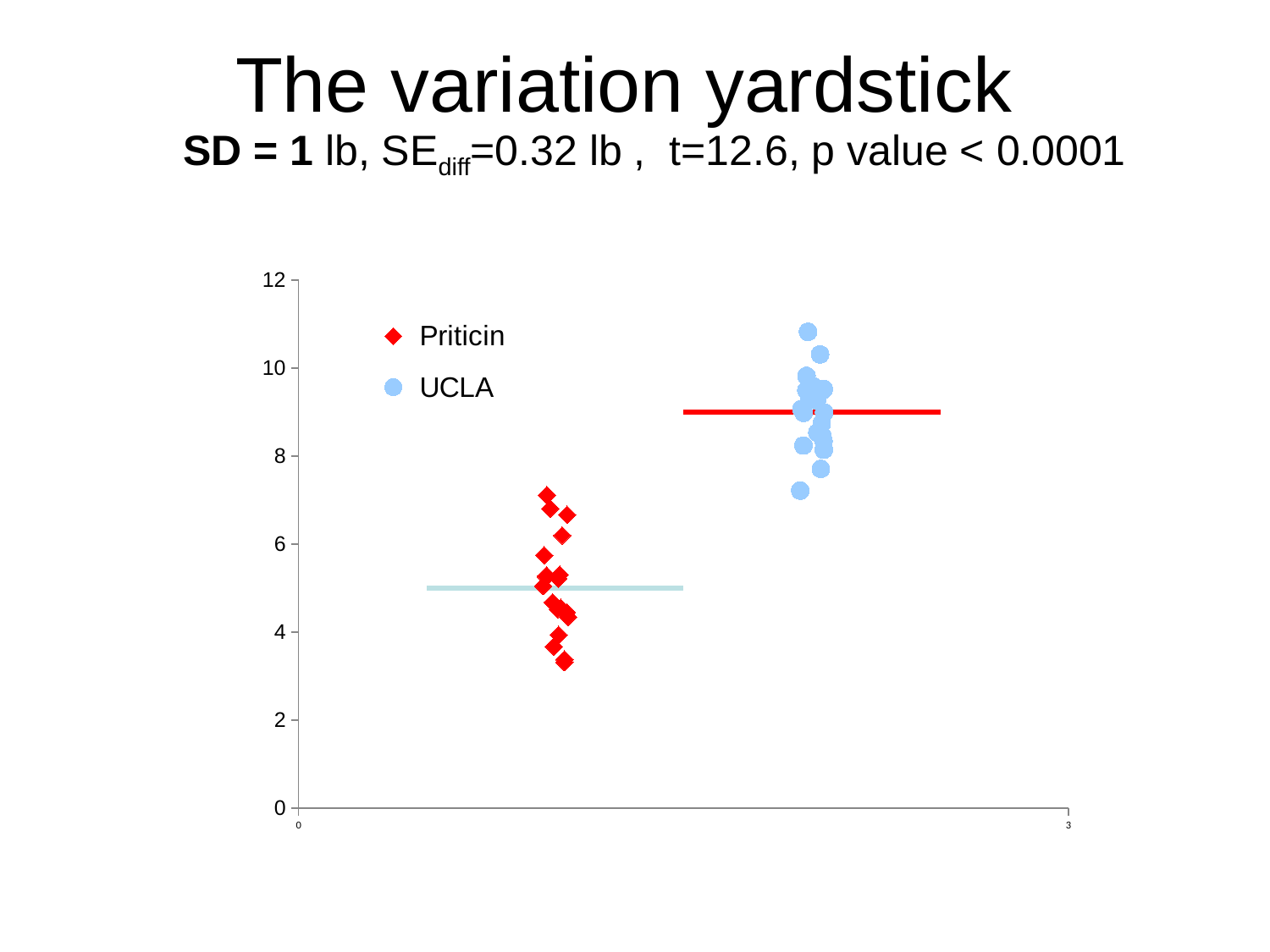
Are the Priticin data points greater or less than 8 on the vertical axis? less What are the two series named in the legend? Priticin and UCLA How many series does the legend list? 2 Is the horizontal line drawn through the Priticin points greater or less than 6? less What kind of chart is shown on the slide? Scatter chart What is the lowest value labelled on the vertical axis? 0 What is the highest value labelled on the vertical axis? 12 Are the UCLA data points greater or less than 6 on the vertical axis? greater Which series has the lowest plotted point on the chart? Priticin Which series is plotted with red diamond markers? Priticin Which series has the higher values overall, Priticin or UCLA? UCLA